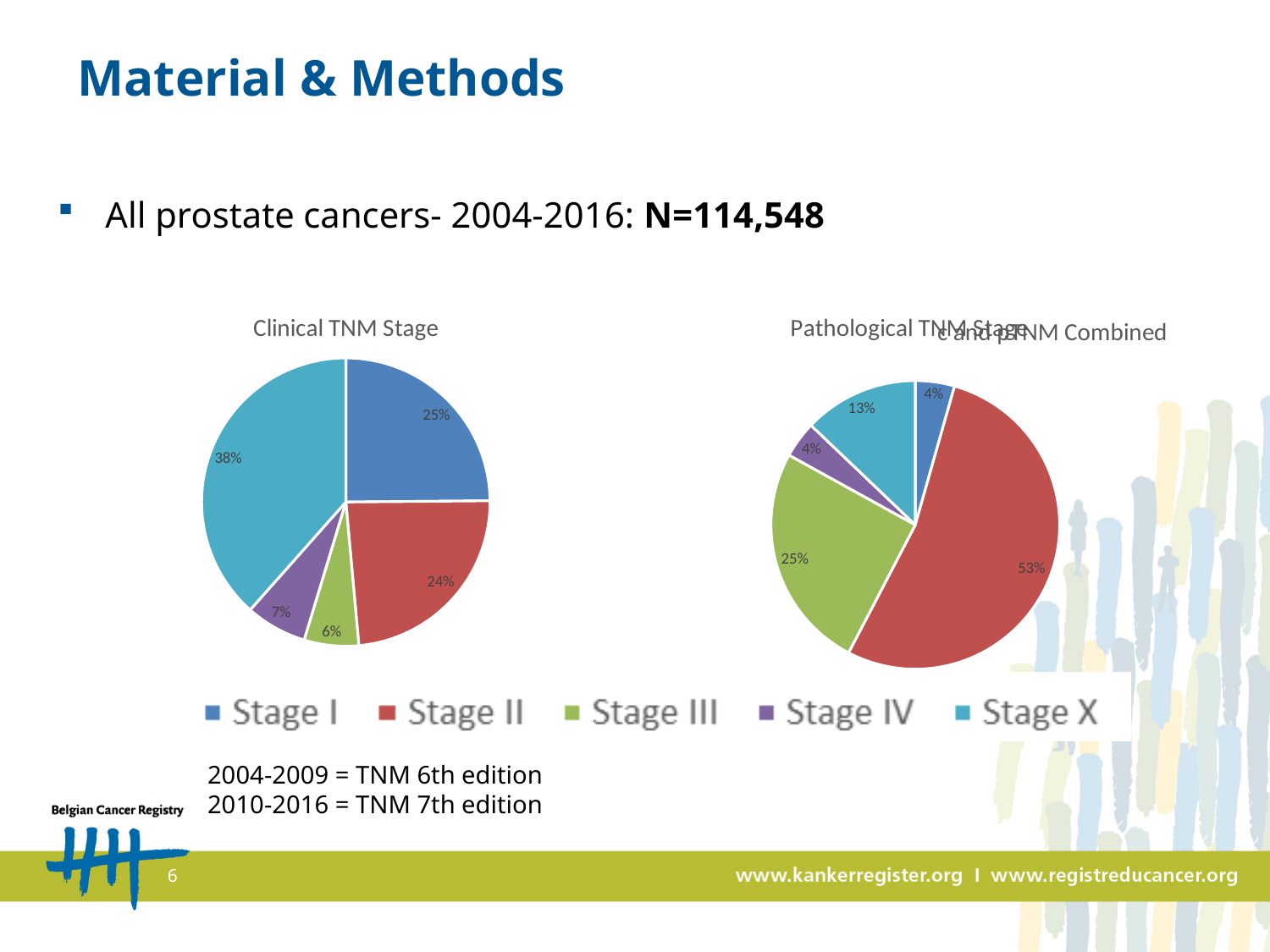
In the Clinical TNM Stage pie chart, what share is Stage X? 38% In the Clinical TNM Stage pie chart, which stage has the smallest share? Stage III In the pie chart on the right, what share is Stage II? 53% In the pie chart on the right, what is the difference between the Stage II and Stage III shares? 28% What type of chart is the Clinical TNM Stage chart? Pie chart In the pie chart on the right, which stage has the largest share? Stage II In the Clinical TNM Stage pie chart, what is the difference between the Stage I and Stage III shares? 19% In the pie chart on the right, what share is Stage X? 13% In the Clinical TNM Stage pie chart, what share is Stage II? 24% How many stages does the legend list? 5 Which is larger: the Stage I share in the Clinical TNM Stage pie chart or the Stage I share in the pie chart on the right? Clinical TNM Stage In the Clinical TNM Stage pie chart, which stage has the largest share? Stage X